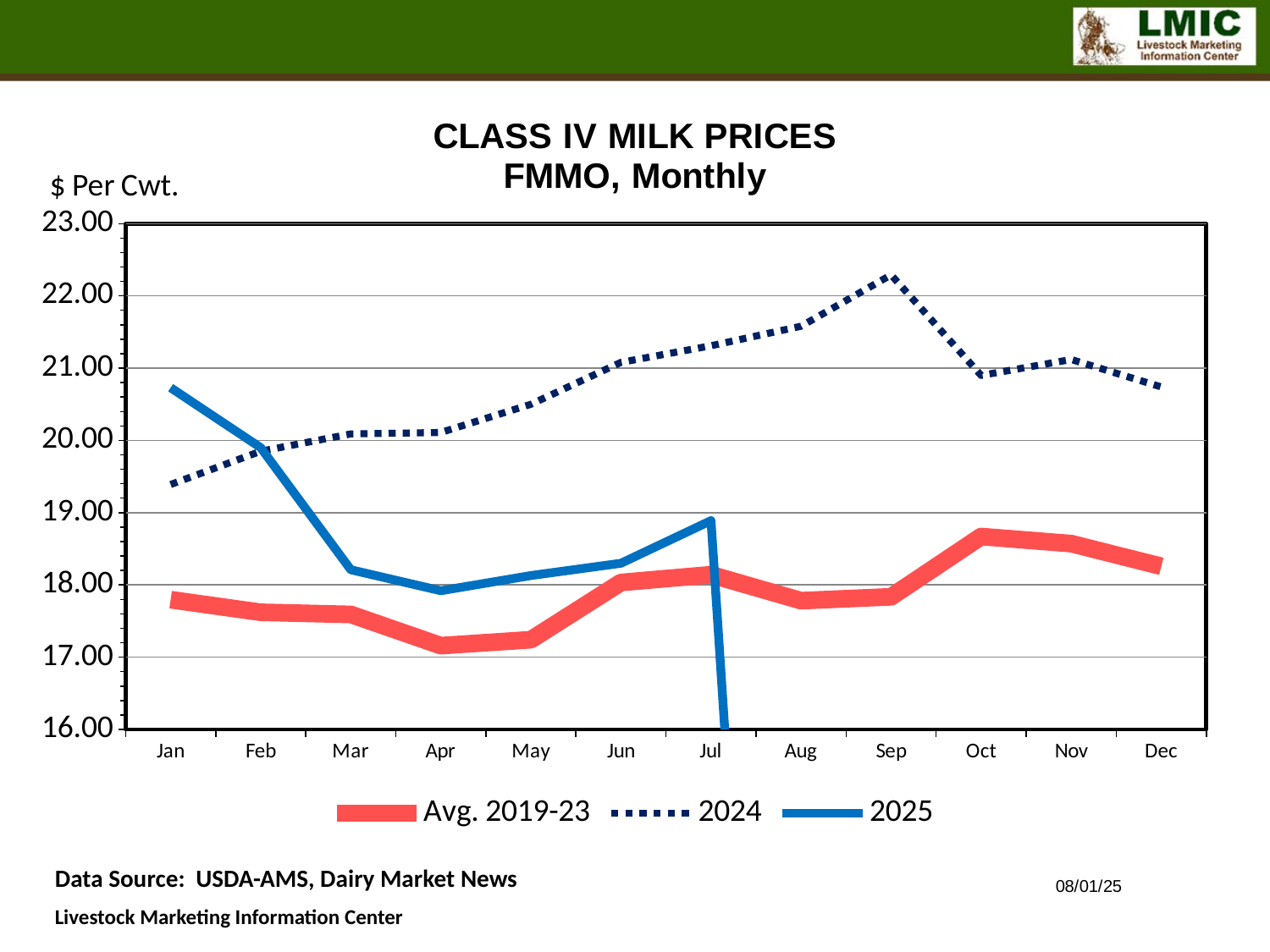
Is the 2024 value for Sep greater or less than 22.00? greater In which month does the Avg. 2019-23 series reach its highest value? Oct Is the 2025 value for Jan greater or less than 20.00? greater How many months are shown along the x axis? 12 In Jan, which series has the higher value, 2024 or 2025? 2025 What unit is shown on the y axis of the chart? $ Per Cwt. In which month does the 2024 series reach its highest value? Sep Is the Avg. 2019-23 value for Apr greater or less than 18.00? less Does the 2025 series rise or fall from Jan to Apr? fall In which month is the 2024 series at its lowest value? Jan How many series does the legend list? 3 What kind of chart is shown on the slide? line chart